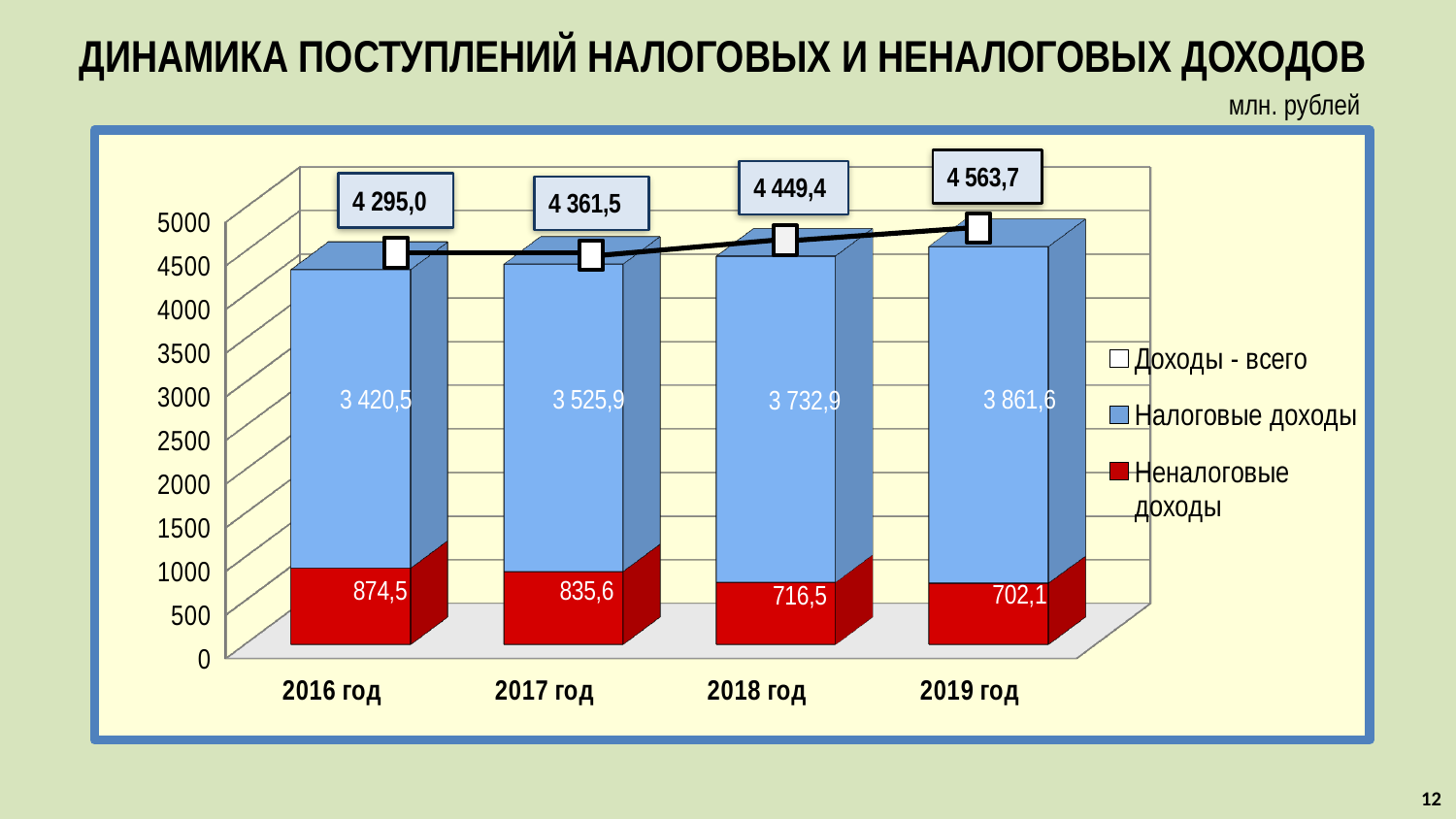
Which is larger: Доходы - всего in 2017 год or in 2018 год? 2018 год What is the difference between Неналоговые доходы in 2016 год and 2019 год? 172,4 Which year has the lowest value of Неналоговые доходы? 2019 год What unit is stated for the values on the chart? млн. рублей Which year has the highest value of Налоговые доходы? 2019 год What is the value of Неналоговые доходы for 2018 год? 716,5 What is the value of Налоговые доходы for 2016 год? 3 420,5 What is the difference between Налоговые доходы in 2019 год and 2016 год? 441,1 Do the values of Неналоговые доходы rise or fall from 2016 год to 2019 год? fall What is the value of Доходы - всего for 2019 год? 4 563,7 How many years are shown on the x axis? 4 How many series does the legend list? 3